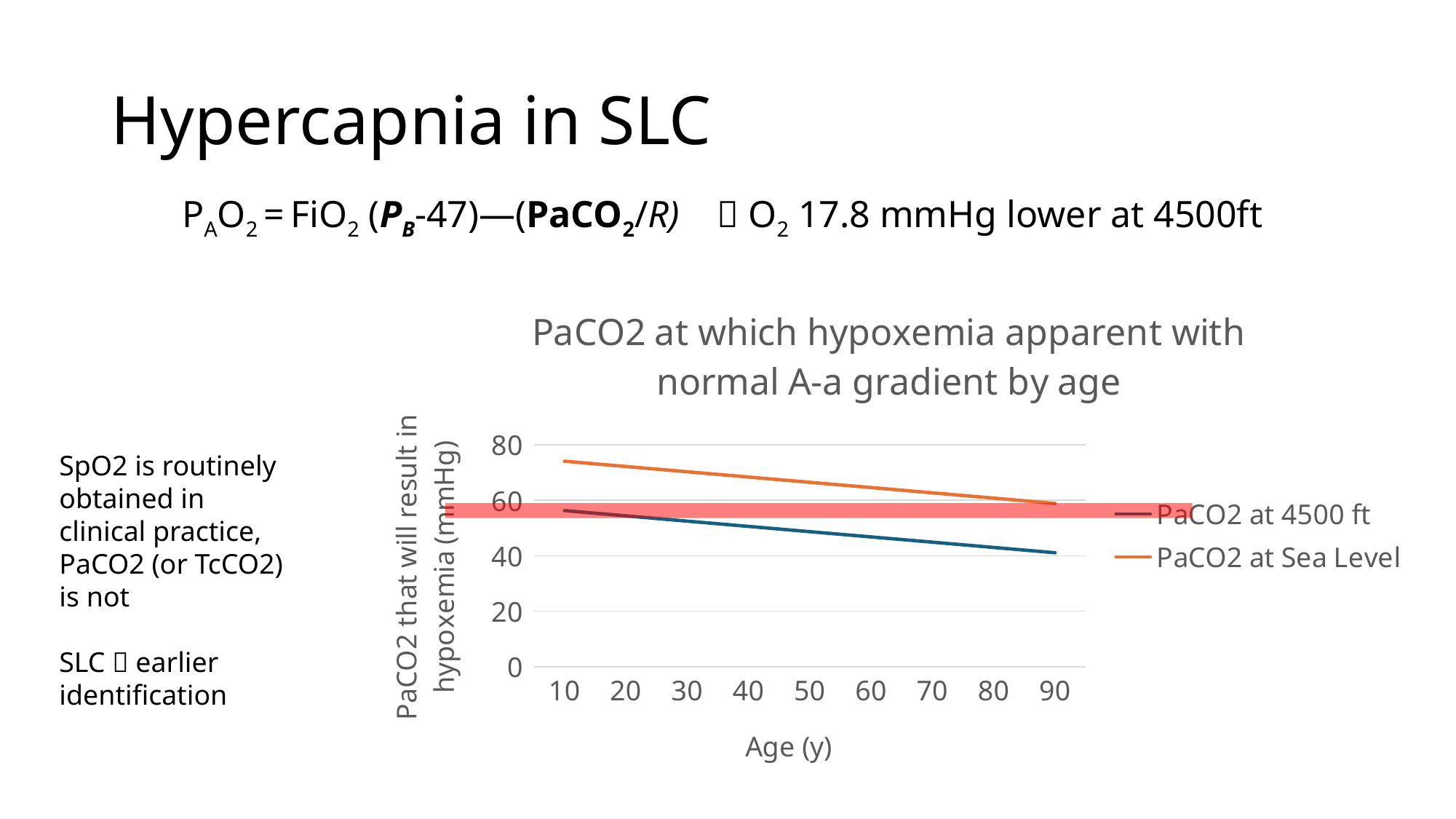
Is the value for PaCO2 at 4500 ft at age 10 greater or less than 40? greater Does the PaCO2 at 4500 ft line rise or fall as age increases? fall At age 90, which series has the lower value: PaCO2 at 4500 ft or PaCO2 at Sea Level? PaCO2 at 4500 ft What kind of chart is shown on the slide? line chart What is the title of the chart? PaCO2 at which hypoxemia apparent with normal A-a gradient by age Does the PaCO2 at Sea Level line rise or fall as age increases? fall How many series does the chart legend list? 2 Is the value for PaCO2 at Sea Level at age 10 greater or less than 60? greater How many age values are marked on the x axis of the chart? 9 Is the value for PaCO2 at 4500 ft at age 90 greater or less than 60? less At age 10, which series has the higher value: PaCO2 at 4500 ft or PaCO2 at Sea Level? PaCO2 at Sea Level What is the label of the x axis of the chart? Age (y)